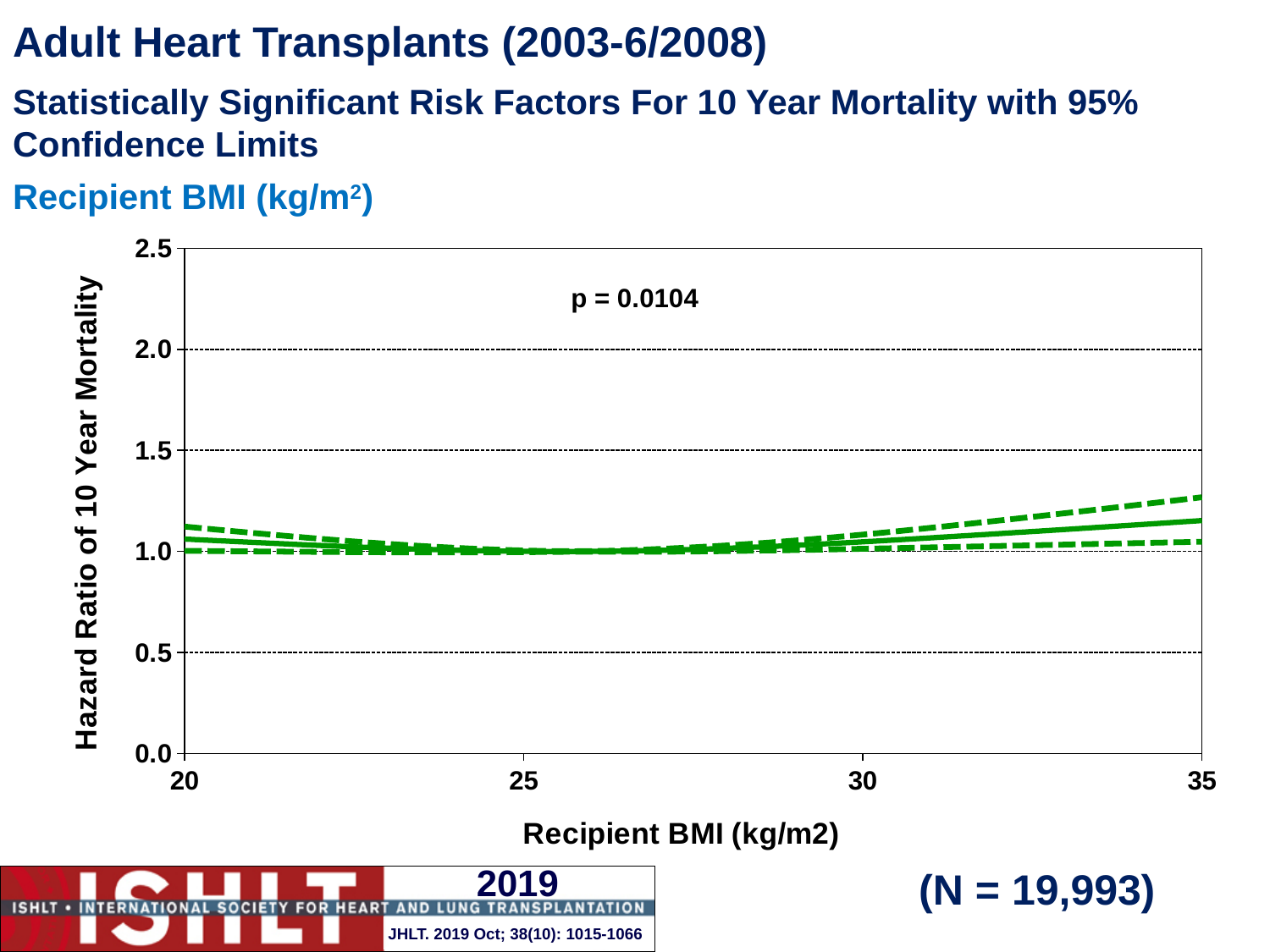
What p-value is printed on the chart? p = 0.0104 Is the hazard ratio (solid line) at a recipient BMI of 25 greater or less than 2.0? less Is the hazard ratio (solid line) at a recipient BMI of 35 greater or less than 1.0? greater What kind of chart is shown on the slide? line chart How many lines are plotted on the chart? 3 Which is larger, the hazard ratio (solid line) at a recipient BMI of 35 or at a recipient BMI of 25? 35 Is the upper confidence limit (upper dashed line) at a recipient BMI of 35 greater or less than 1.5? less Between a recipient BMI of 25 and 35, does the hazard ratio (solid line) rise or fall? rise What is the highest value labelled on the y axis of the chart? 2.5 How many tick labels are shown on the x axis of the chart? 4